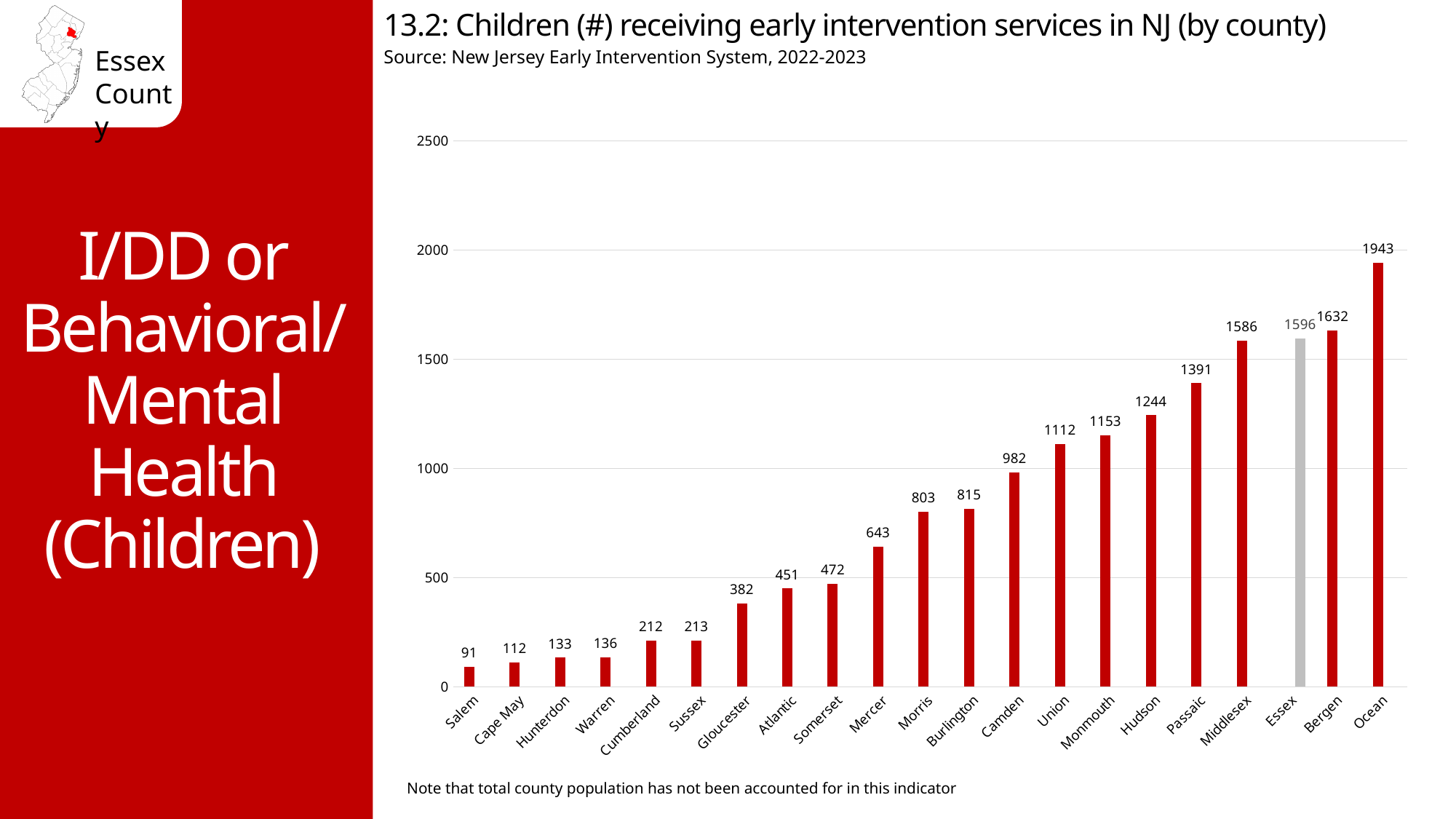
What is the difference between the values for Bergen and Middlesex? 46 Which county has a larger value, Camden or Union? Union Which county has a larger value, Mercer or Gloucester? Mercer Which county has the highest number of children receiving early intervention services? Ocean What is the difference between the values for Ocean and Essex? 347 Which county's bar is shown in grey rather than red? Essex Which county has the lowest number of children receiving early intervention services? Salem How many children are receiving early intervention services in Essex County? 1596 How many counties are shown on the x axis of the chart? 21 Is the value for Passaic greater or less than 1500? less What kind of chart is shown on the slide? Bar chart What is the value shown for Hudson County? 1244